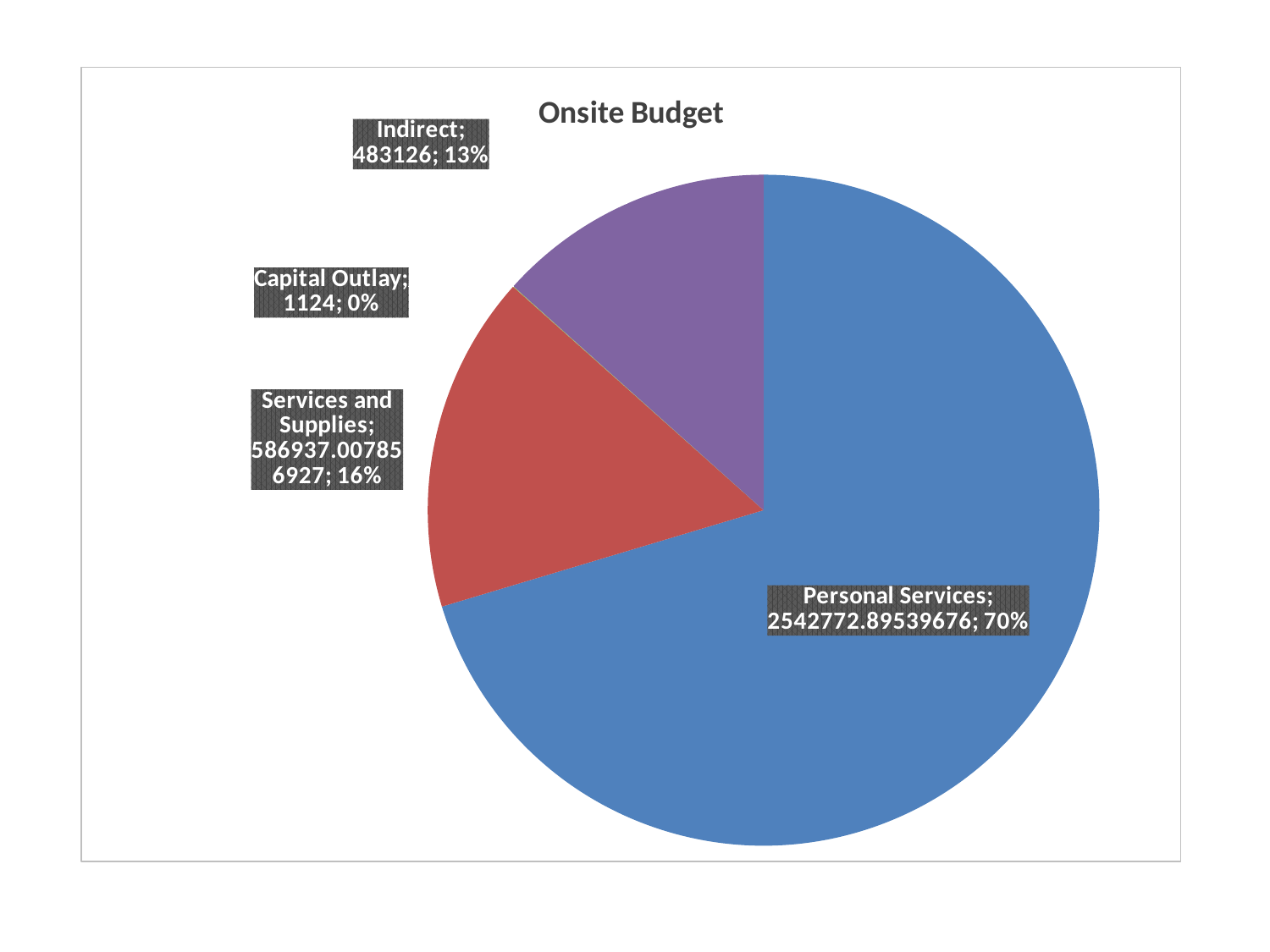
What type of chart is shown on the slide? Pie chart What share of the pie does Personal Services represent? 70% What is the value for Capital Outlay? 1124 Which category has the largest slice? Personal Services Which is larger, Services and Supplies or Indirect? Services and Supplies What is the value for Personal Services? 2542772.89539676 What is the title of the chart? Onsite Budget What is the value for Indirect? 483126 What is the difference between the values for Indirect and Capital Outlay? 482002 Which category has the smallest slice? Capital Outlay How many slices does the pie chart have? 4 What share of the pie does Services and Supplies represent? 16%